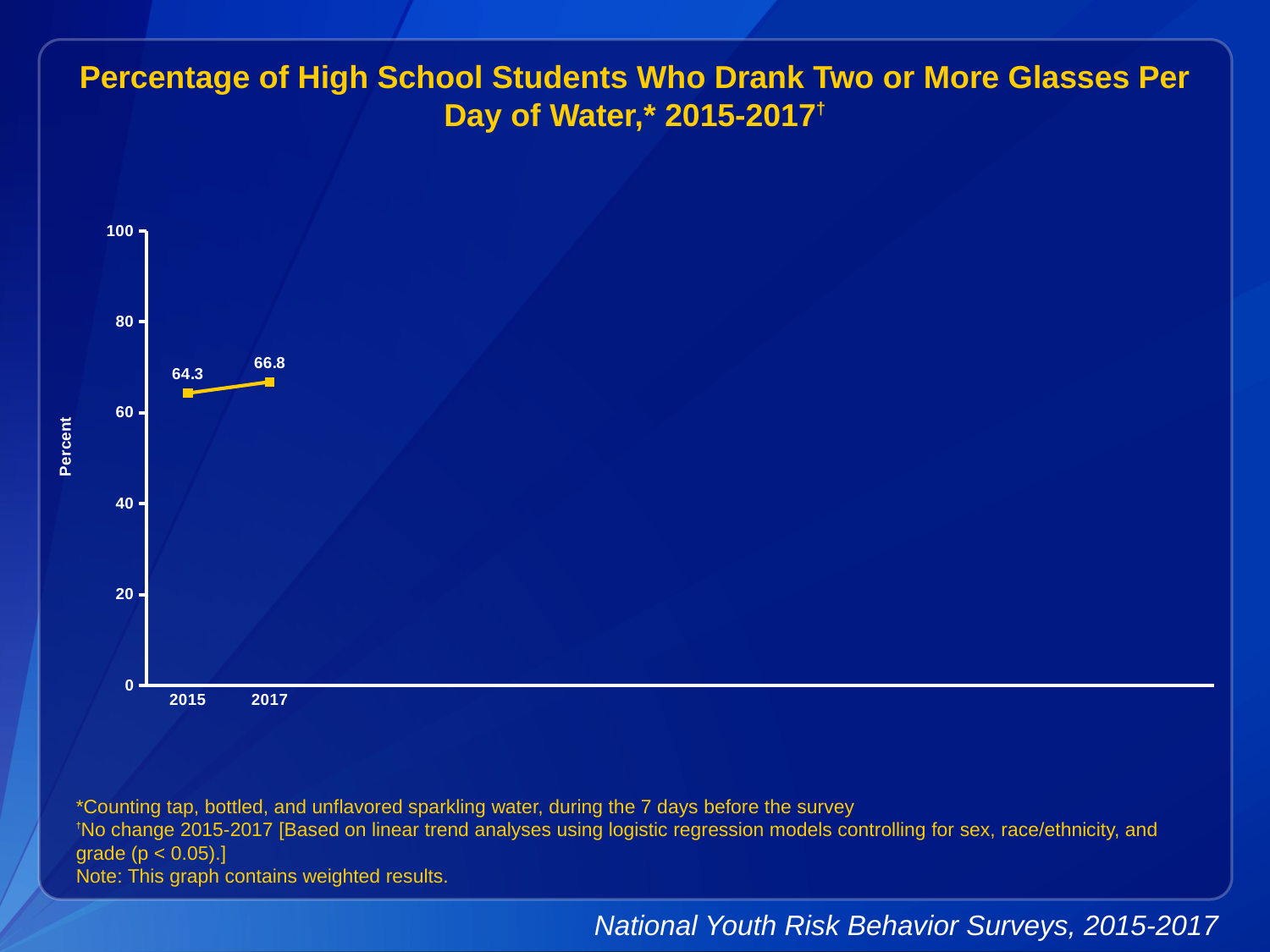
What is the difference between the 2017 and 2015 values? 2.5 How many data points are plotted on the chart? 2 Which year has the lower value? 2015 Do the values rise or fall from 2015 to 2017? rise Is the value for 2015 greater or less than 60? greater Which year has the higher value? 2017 What is the label on the y axis? Percent Is the value for 2017 greater or less than 80? less What is the maximum value shown on the y axis? 100 What kind of chart is shown on the slide? line chart What is the value for 2015? 64.3 What is the value for 2017? 66.8